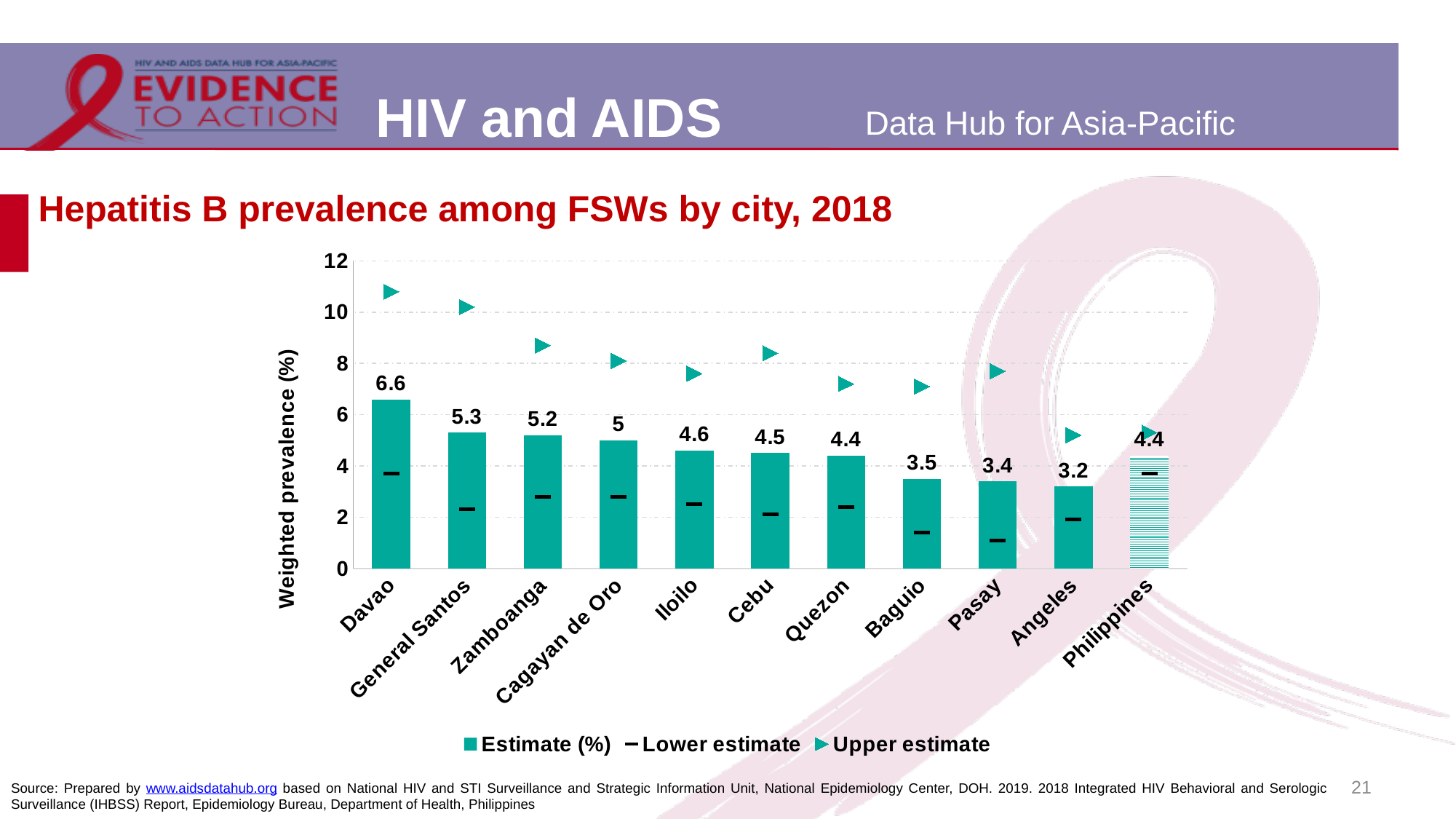
What is the label of the y axis? Weighted prevalence (%) Which city has the lowest estimated Hepatitis B prevalence? Angeles What is the estimated Hepatitis B prevalence among FSWs in Davao? 6.6 Which city has the highest estimated Hepatitis B prevalence? Davao What is the estimate (%) shown for the Philippines overall? 4.4 How many categories (cities plus the national figure) are shown on the x axis? 11 Is the upper estimate for Davao greater or less than 10? greater How many series does the legend list? 3 What is the difference between the estimates for Davao and Angeles? 3.4 What kind of chart is used on this slide? Bar chart What is the estimate (%) shown for Cagayan de Oro? 5 Which has a higher estimate, General Santos or Baguio? General Santos